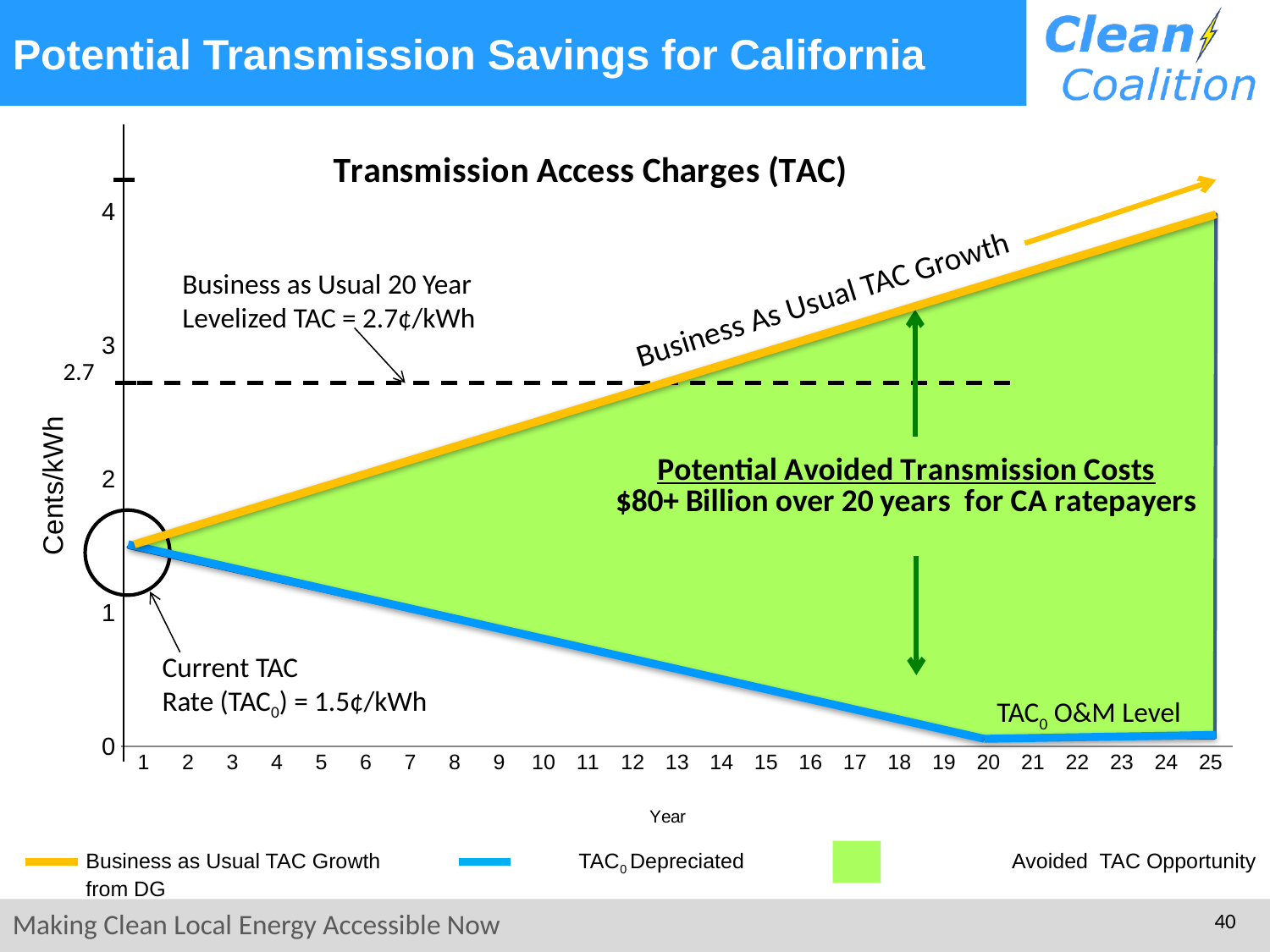
Does the Business as Usual TAC Growth line rise or fall as the years increase? rises How many series does the chart legend list? 3 What kind of chart is shown on the slide? line chart What is the Current TAC Rate (TAC0) shown on the chart? 1.5¢/kWh What is the Business as Usual 20 Year Levelized TAC value shown on the chart? 2.7¢/kWh Is the value of the TAC0 Depreciated line at year 20 greater or less than 1? less Does the TAC0 Depreciated line rise or fall as the years increase? falls What is the label on the vertical axis of the chart? Cents/kWh What is the title of the chart? Transmission Access Charges (TAC) Is the value of the Business as Usual TAC Growth line at year 25 greater or less than 3? greater How many years are marked along the x axis of the chart? 25 At year 15, which line is higher: Business as Usual TAC Growth or TAC0 Depreciated? Business as Usual TAC Growth